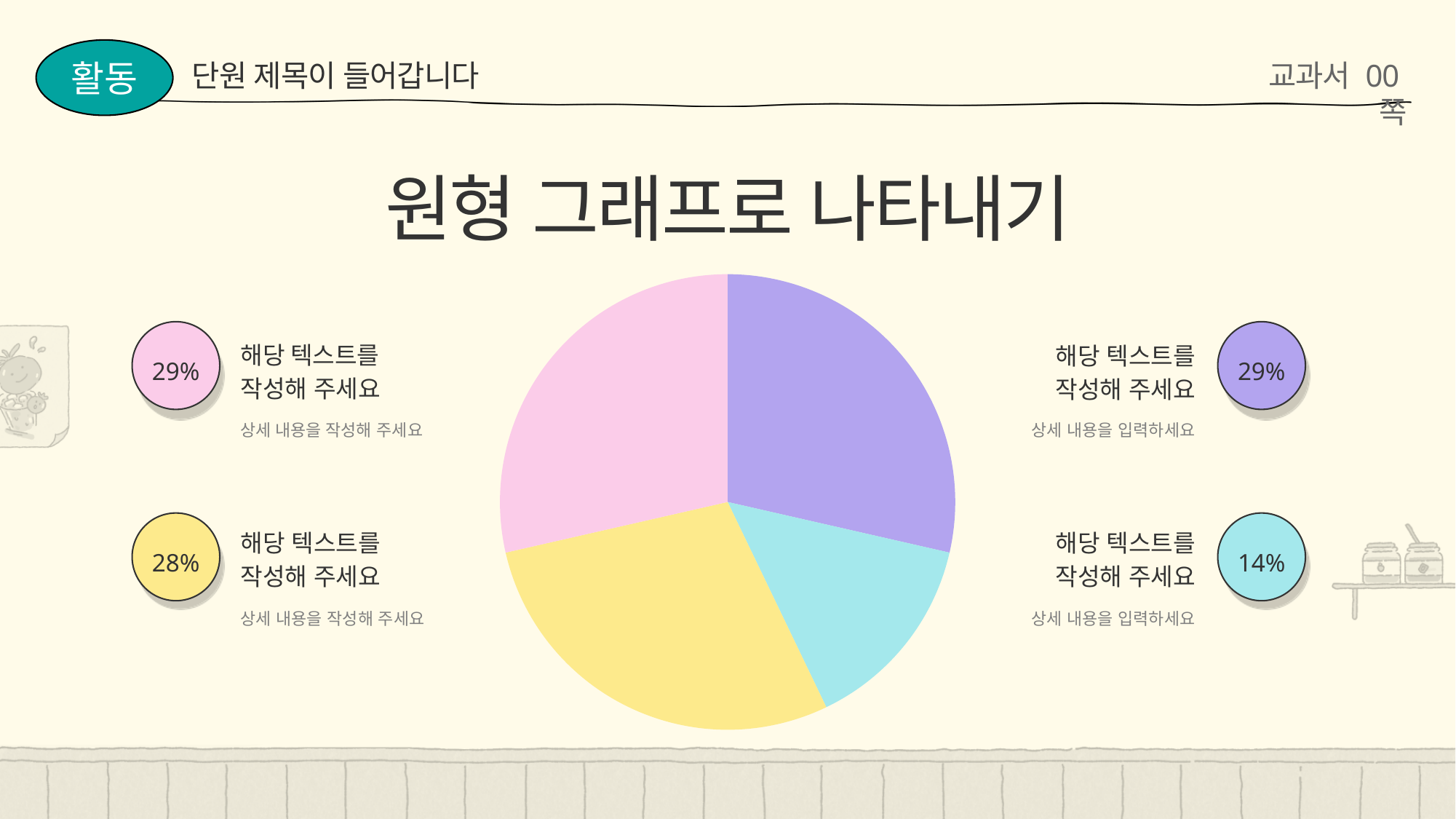
Which is larger, the yellow slice or the light blue slice? the yellow slice What percentage is shown for the light blue slice of the pie chart? 14% What is the title of the slide containing the pie chart? 원형 그래프로 나타내기 How many slices does the pie chart have? 4 What share of the pie does the light blue slice represent? 14% What percentage is shown for the pink slice of the pie chart? 29% What percentage is shown for the purple slice of the pie chart? 29% What kind of chart is shown on the slide? pie chart What percentage is shown for the yellow slice of the pie chart? 28% What is the difference between the purple slice's percentage and the light blue slice's percentage? 15% What is the difference between the yellow slice's percentage and the light blue slice's percentage? 14% Which slice of the pie chart is the smallest? the light blue slice